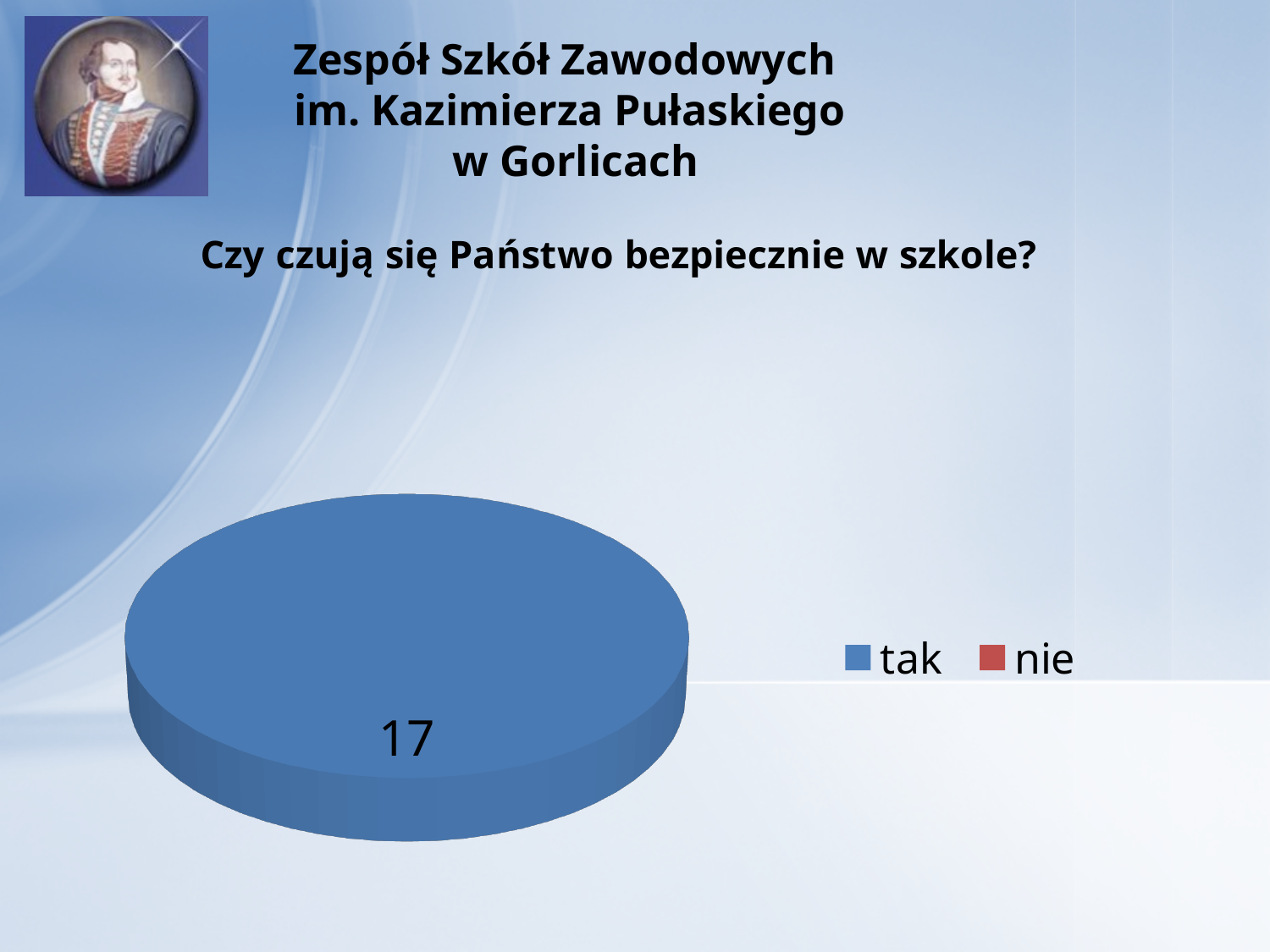
What value is shown for the "tak" slice of the pie chart? 17 What colour is the "tak" slice in the pie chart? blue Is the value for "tak" greater or less than 10? greater How many entries does the legend of the pie chart list? 2 Which category has the largest slice in the pie chart? tak What kind of chart is shown on the slide? pie chart What question is the pie chart about, according to the text above it? Czy czują się Państwo bezpiecznie w szkole?